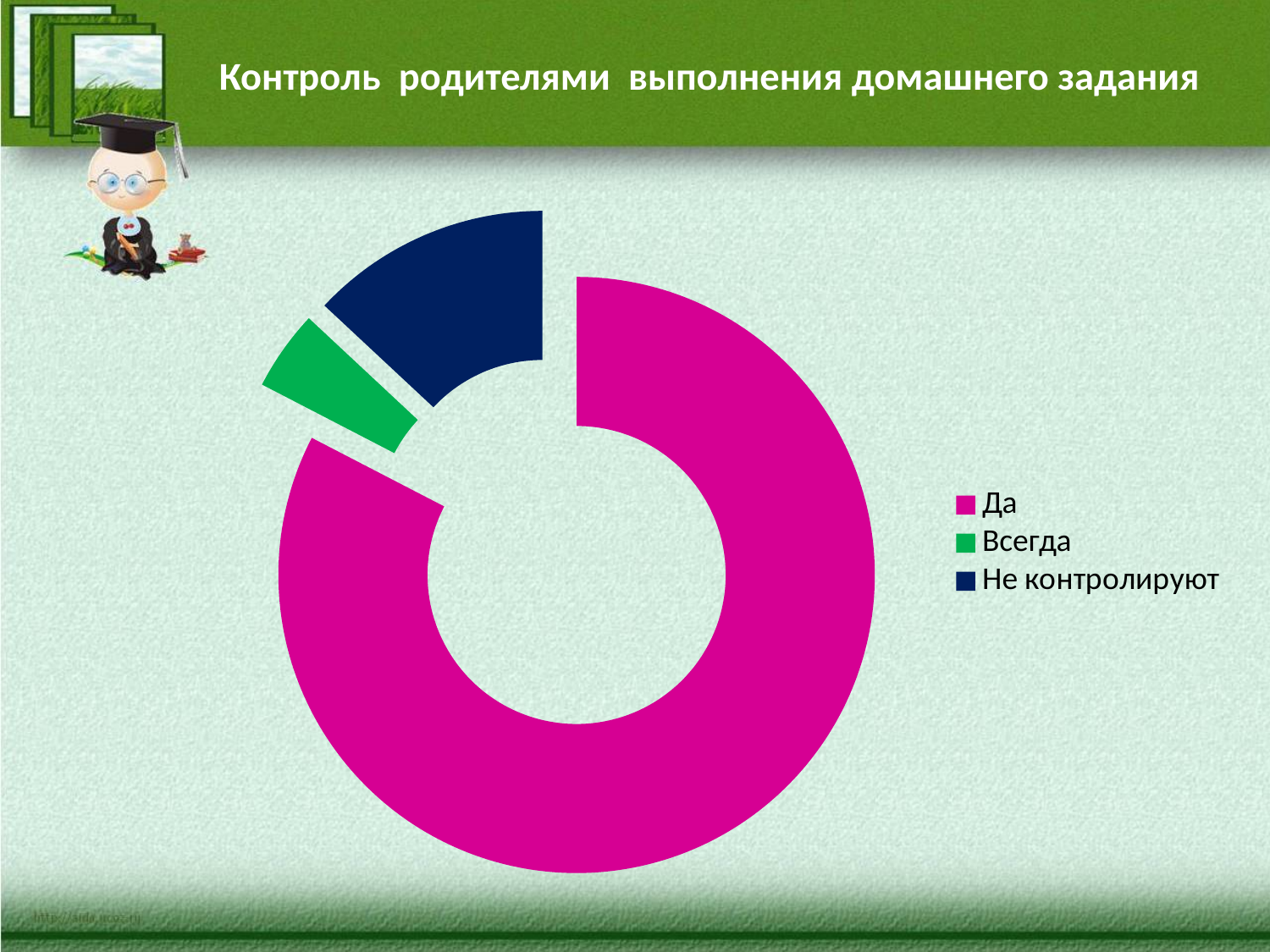
Which category has a larger share: Да or Не контролируют? Да Is the share for Не контролируют greater or less than 25%? less Is the share for Да greater or less than 50%? greater What colour represents the category Не контролируют in the chart? Dark blue Is the share for Всегда greater or less than 10%? less What kind of chart is shown on the slide? Doughnut chart Which category has a larger share: Всегда or Не контролируют? Не контролируют What is the title of the slide containing the chart? Контроль родителями выполнения домашнего задания Which category has the smallest share of the chart? Всегда How many categories does the chart show? 3 Which category has the largest share of the chart? Да